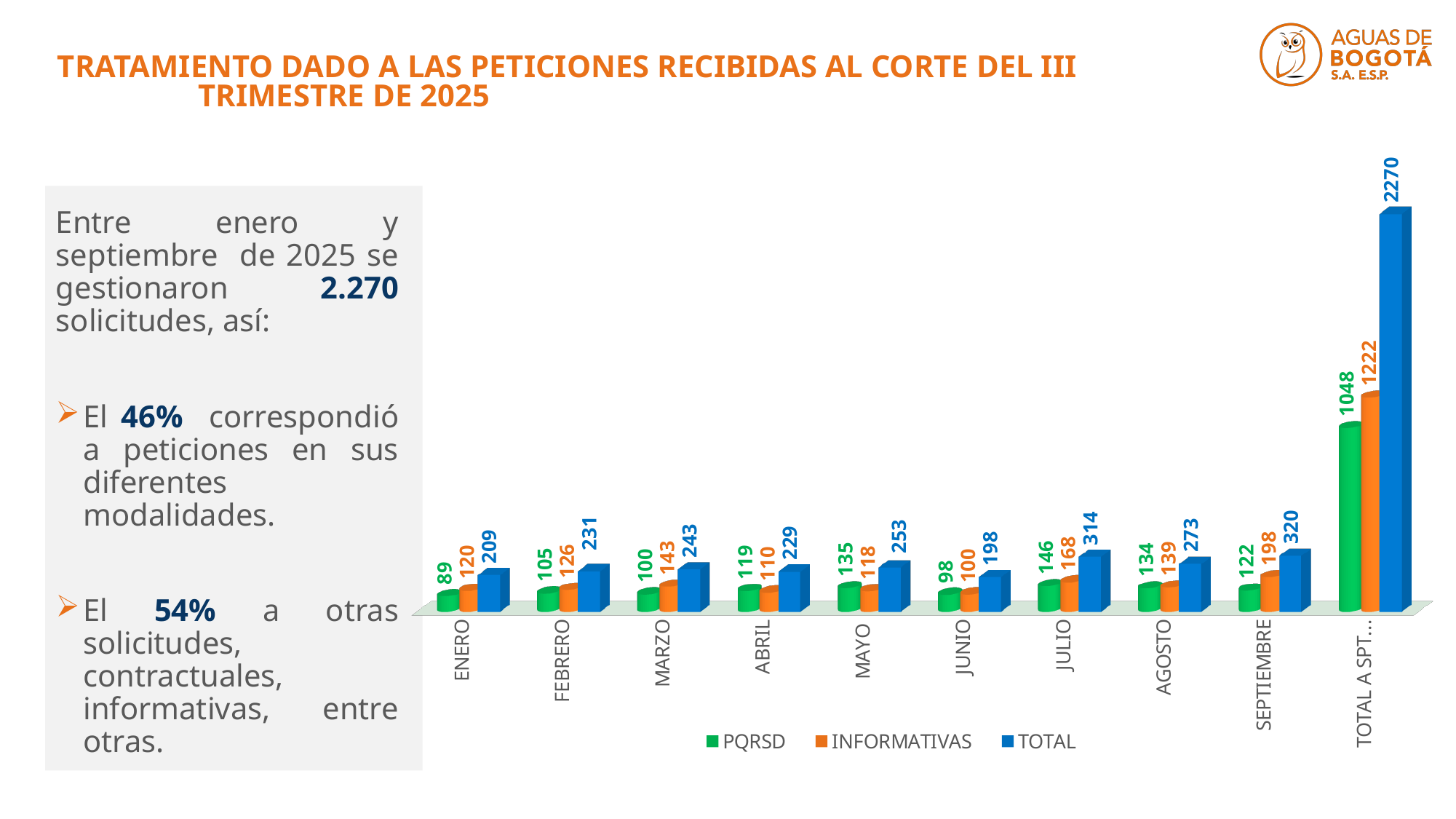
What is the difference between the TOTAL values for JULIO and JUNIO? 116 Which colour represents the TOTAL series in the chart? Blue What is the difference between the INFORMATIVAS values for MARZO and ENERO? 23 How many series does the legend list? 3 What kind of chart is shown on the slide? Bar chart Which is larger for ABRIL: the PQRSD value or the INFORMATIVAS value? PQRSD What is the PQRSD value for ENERO? 89 How many categories are shown on the x axis? 10 What is the INFORMATIVAS value for SEPTIEMBRE? 198 Among the months ENERO to SEPTIEMBRE, which month has the lowest PQRSD value? ENERO What is the TOTAL value for JULIO? 314 Among the months ENERO to SEPTIEMBRE, which month has the highest TOTAL value? SEPTIEMBRE